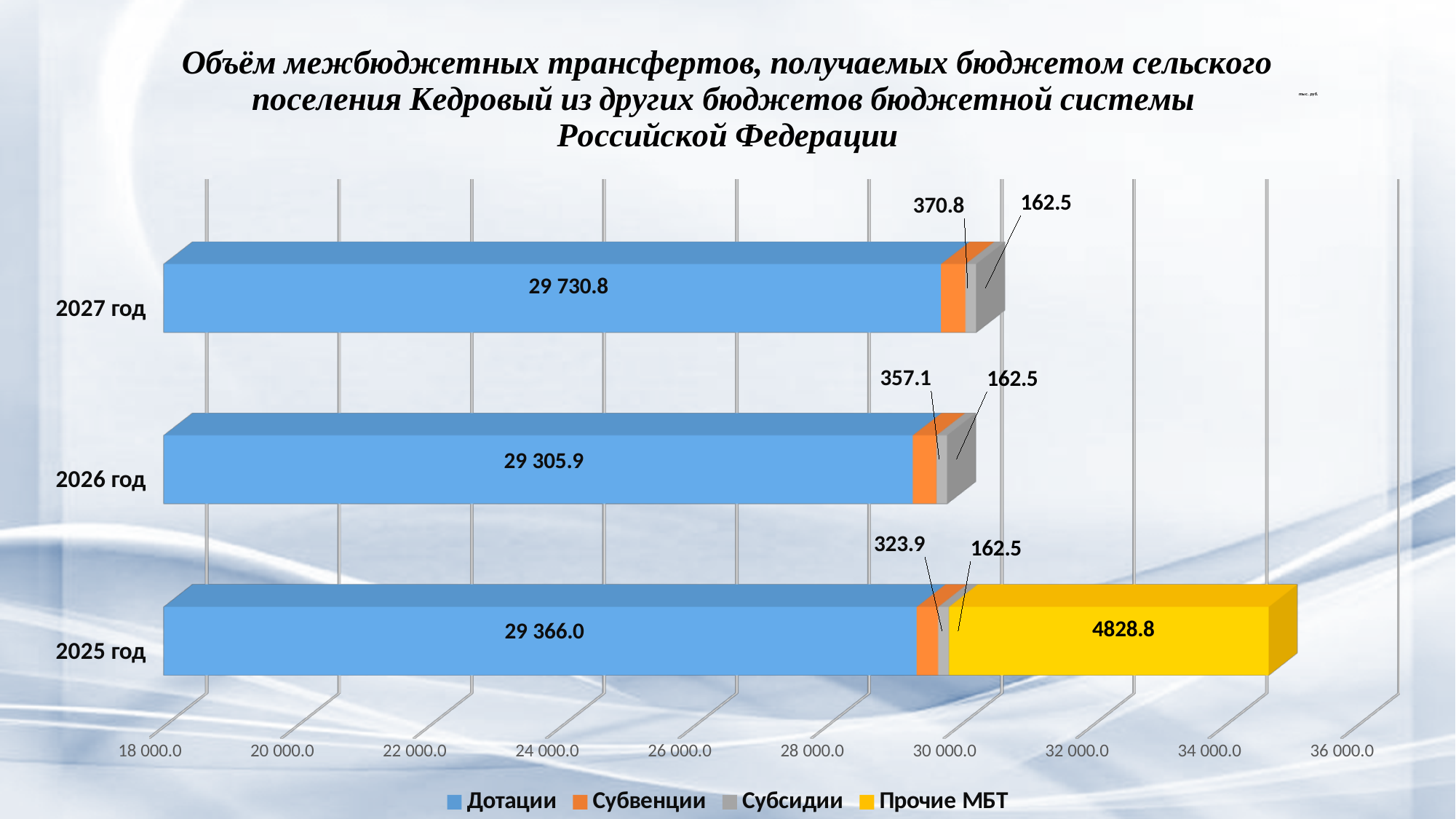
Which year has the lowest value of Субвенции? 2025 год How many series does the legend list? 4 What is the value of Субсидии for 2025 год? 162.5 What kind of chart is shown on the slide? Stacked bar chart Which series is shown in yellow in the legend? Прочие МБТ Which year has the highest value of Дотации? 2027 год What is the total of the stacked bar for 2025 год? 34 681.2 What is the value of Дотации for 2027 год? 29 730.8 What is the value of Прочие МБТ for 2025 год? 4828.8 How many years (categories) are shown on the chart? 3 What is the difference between the Дотации values for 2027 год and 2026 год? 424.9 What is the value of Субвенции for 2026 год? 357.1